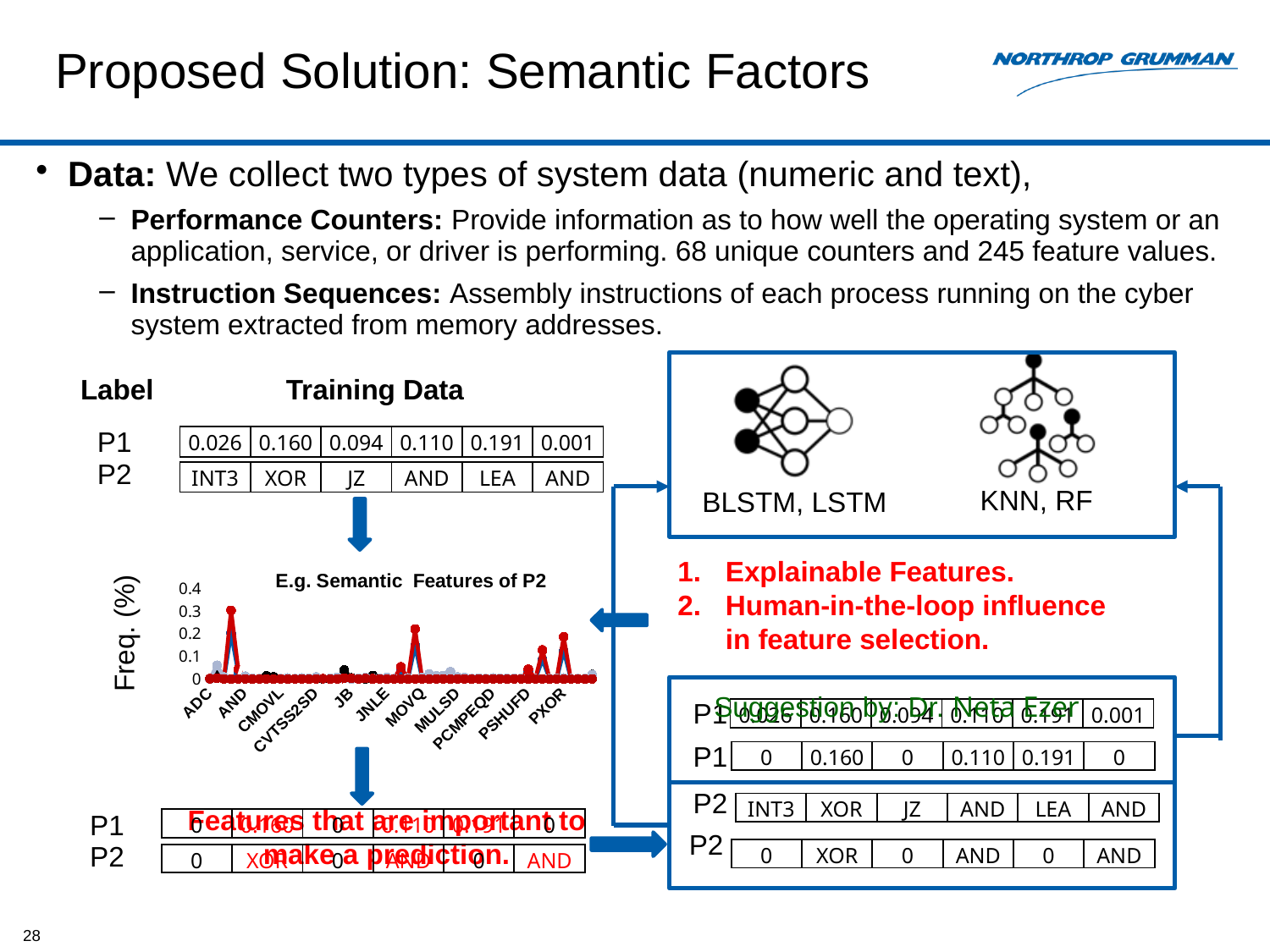
In the 'E.g. Semantic Features of P2' chart, is the highest peak greater or less than 0.2? greater In the 'E.g. Semantic Features of P2' chart, is the highest peak greater or less than 0.4? less What is the highest tick value shown on the y-axis of the 'E.g. Semantic Features of P2' chart? 0.4 In the 'E.g. Semantic Features of P2' chart, is the peak near MOVQ greater or less than 0.1? greater What is the title of the chart on the slide? E.g. Semantic Features of P2 What kind of chart is the 'E.g. Semantic Features of P2' chart? line chart What is the y-axis label of the 'E.g. Semantic Features of P2' chart? Freq. (%) How many category labels are printed along the x-axis of the 'E.g. Semantic Features of P2' chart? 11